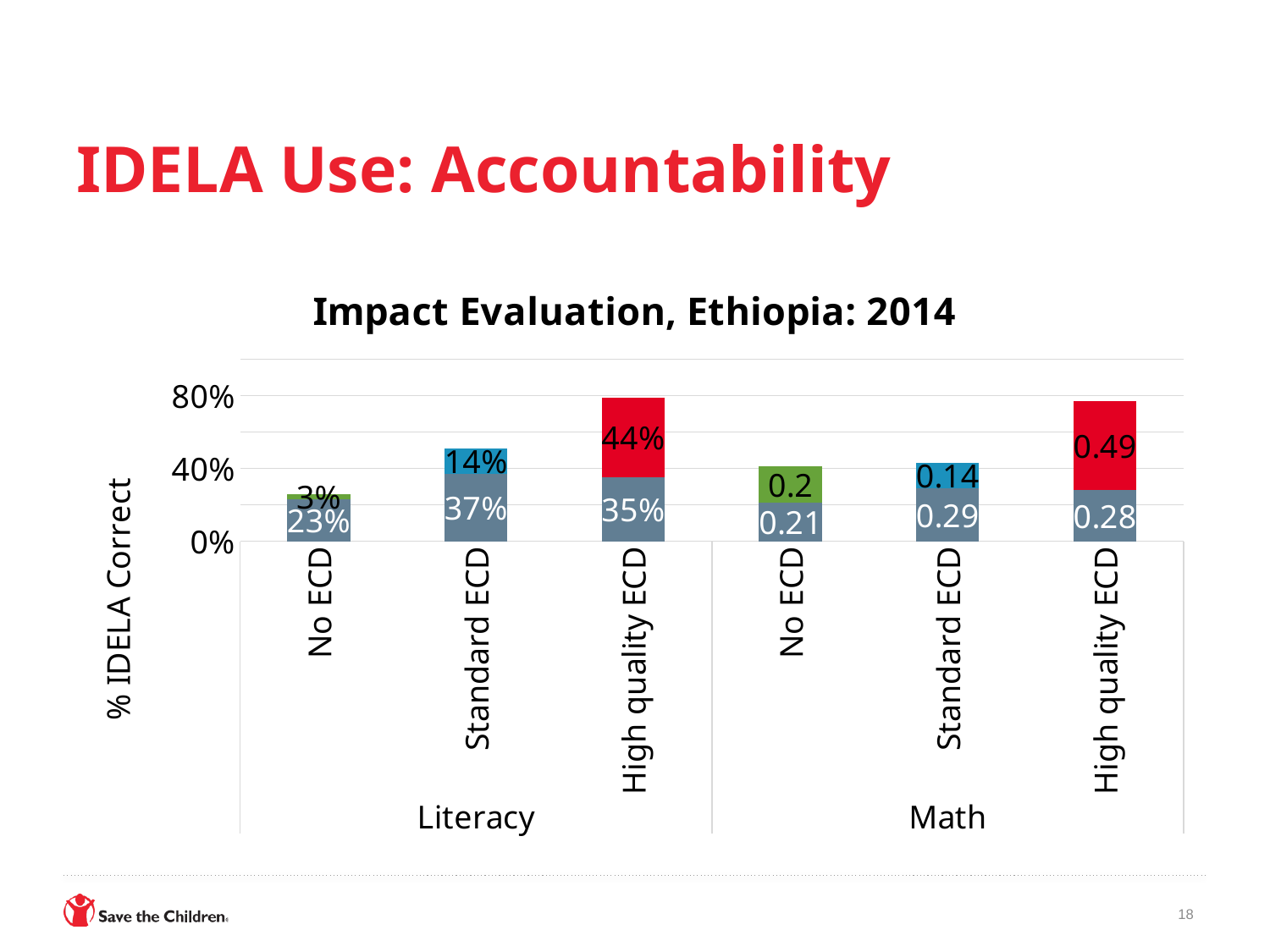
What is the total of the Literacy High quality ECD stacked bar? 79% Which Math category has the tallest stacked bar? High quality ECD Is the total of the Math High quality ECD bar greater or less than 40%? greater What is the total of the Literacy Standard ECD stacked bar? 51% What is the value of the bottom segment of the Literacy Standard ECD bar? 37% What is the value of the bottom segment of the Math No ECD bar? 0.21 What is the value of the top segment of the Math Standard ECD bar? 0.14 How many stacked bars are shown in the chart? 6 What is the difference between the top segments of the Literacy High quality ECD bar and the Literacy Standard ECD bar? 30% What is the value of the top segment of the Literacy High quality ECD bar? 44% What is the title of the chart? Impact Evaluation, Ethiopia: 2014 Which Literacy category has the tallest stacked bar? High quality ECD